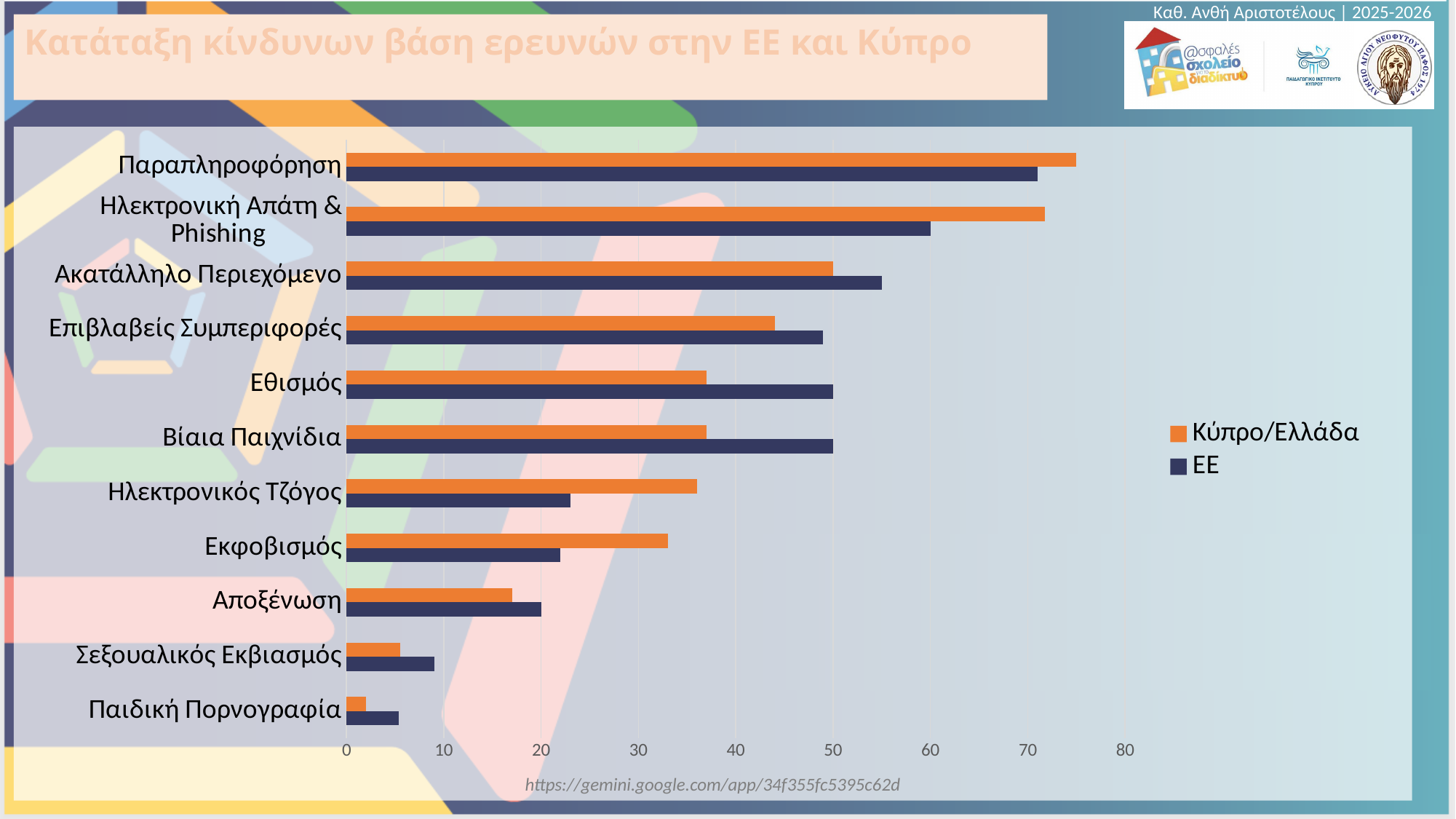
Which series is shown in orange? Κύπρο/Ελλάδα Is the ΕΕ value for Εκφοβισμός greater or less than 30? less Is the Κύπρο/Ελλάδα value for Παραπληροφόρηση greater or less than 70? greater What is the title of the slide containing the chart? Κατάταξη κίνδυνων βάση ερευνών στην ΕΕ και Κύπρο Which category has the lowest value for the ΕΕ series? Παιδική Πορνογραφία How many categories are plotted on the chart? 11 How many series does the legend list? 2 For Εθισμός, which series has the larger value, Κύπρο/Ελλάδα or ΕΕ? ΕΕ For Ηλεκτρονικός Τζόγος, which series has the larger value, Κύπρο/Ελλάδα or ΕΕ? Κύπρο/Ελλάδα Which category has the highest value for the Κύπρο/Ελλάδα series? Παραπληροφόρηση Which category has the lowest value for the Κύπρο/Ελλάδα series? Παιδική Πορνογραφία What kind of chart is shown on the slide? bar chart